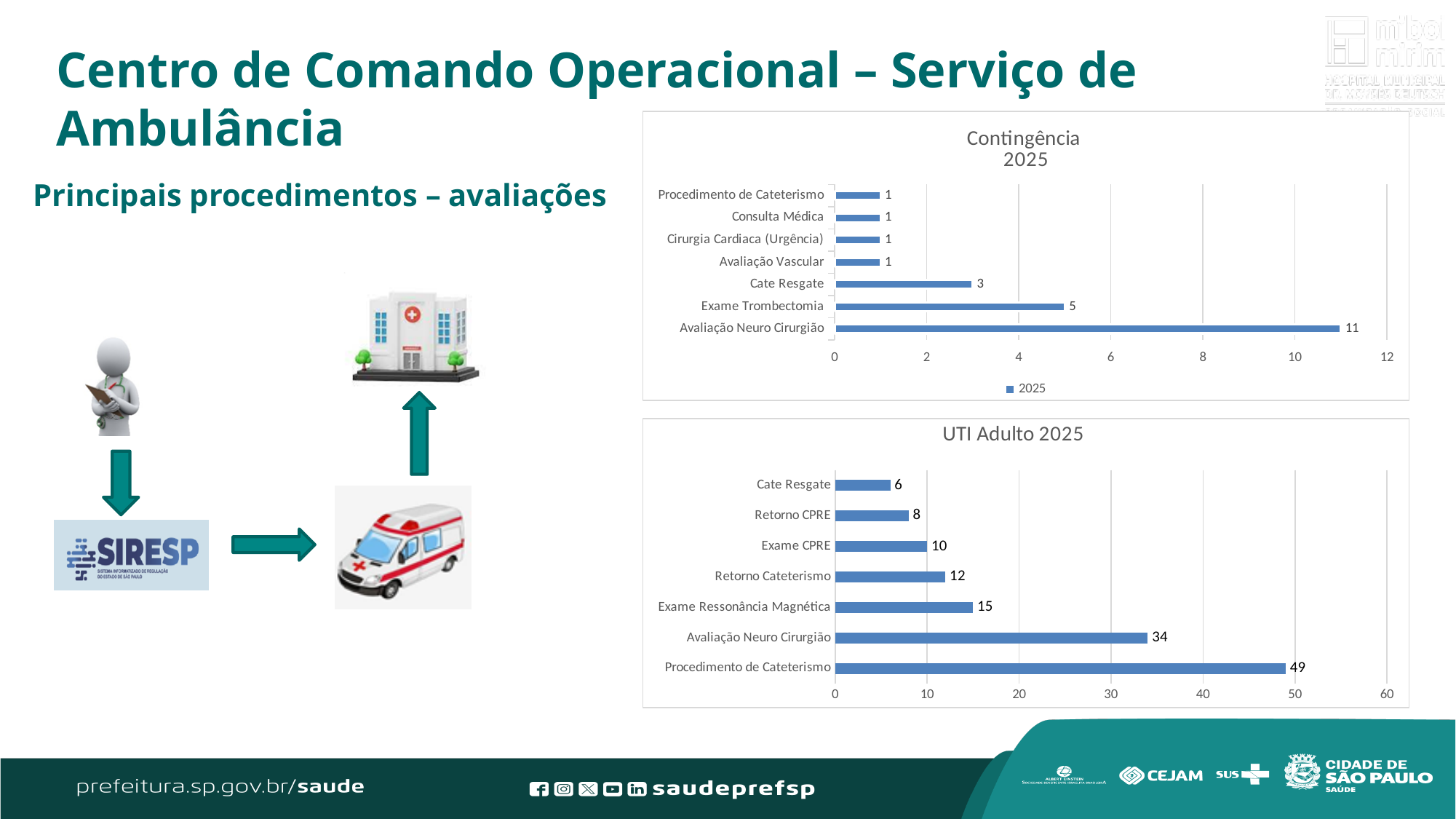
In the 'Contingência 2025' chart, what is the value for Avaliação Neuro Cirurgião? 11 In the 'UTI Adulto 2025' chart, what is the difference between Procedimento de Cateterismo and Avaliação Neuro Cirurgião? 15 In the 'UTI Adulto 2025' chart, which category has the lowest value? Cate Resgate In the 'UTI Adulto 2025' chart, which is larger: Retorno Cateterismo or Exame CPRE? Retorno Cateterismo In the 'Contingência 2025' chart, what is the difference between Avaliação Neuro Cirurgião and Cate Resgate? 8 In the 'UTI Adulto 2025' chart, what is the value for Exame Ressonância Magnética? 15 In the 'Contingência 2025' chart, which category has the highest value? Avaliação Neuro Cirurgião What type of chart is the 'UTI Adulto 2025' chart? Bar chart In the 'Contingência 2025' chart, how many categories are plotted? 7 In the 'Contingência 2025' chart, what is the value for Exame Trombectomia? 5 In the 'UTI Adulto 2025' chart, what is the value for Procedimento de Cateterismo? 49 In the 'Contingência 2025' chart, what series name does the legend show? 2025